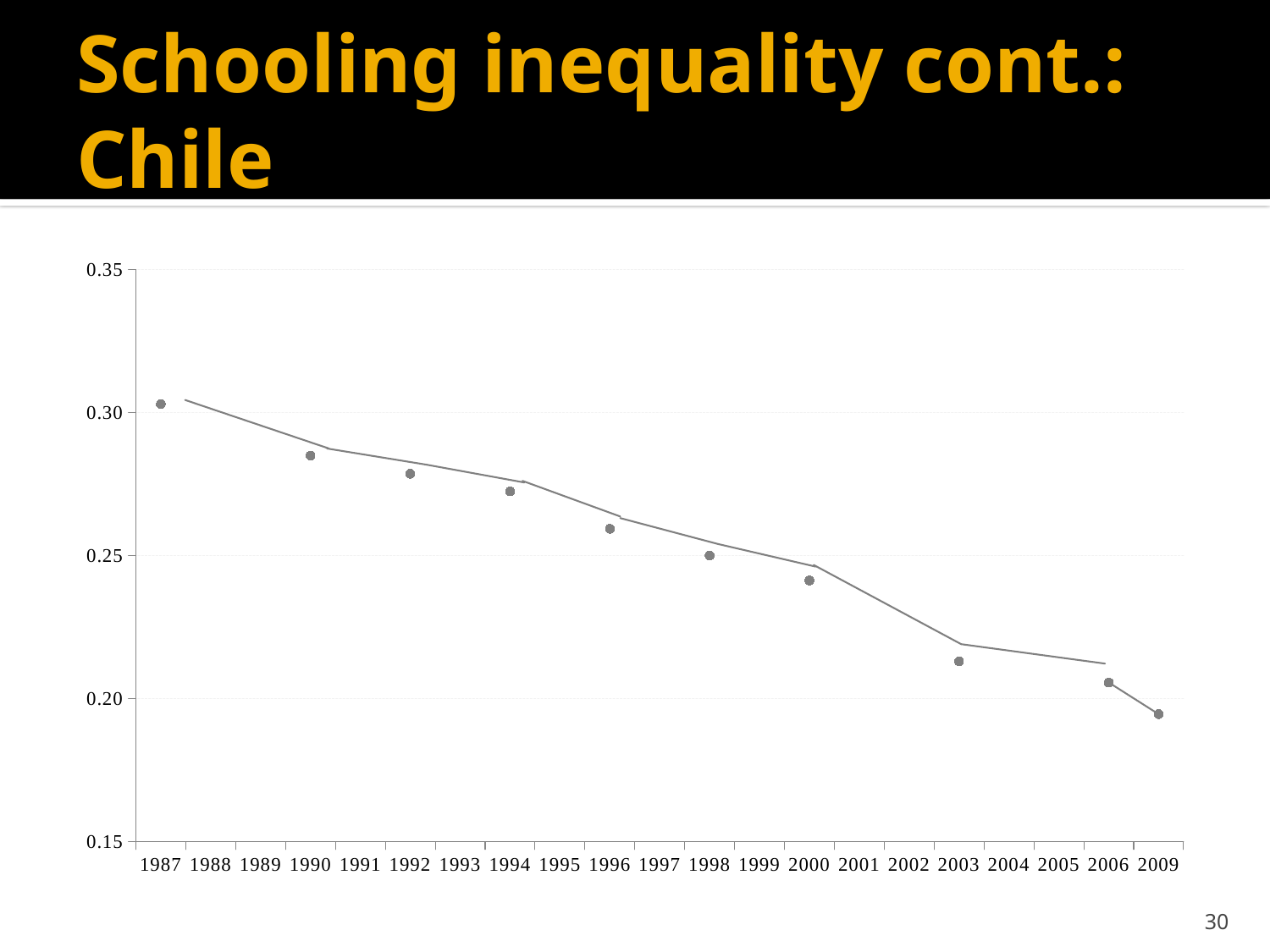
What is the title of the slide containing the chart? Schooling inequality cont.: Chile Is the value for 1996 greater or less than 0.25? greater Which year has the larger plotted value, 1990 or 2006? 1990 Which year has the lowest plotted value? 2009 Is the value for 2003 greater or less than 0.20? greater Is the value for 1990 greater or less than 0.30? less Which year has the highest plotted value? 1987 How many data points (dots) are plotted on the chart? 10 Do the plotted values rise or fall from 1987 to 2009? fall What kind of chart is shown on the slide? line chart